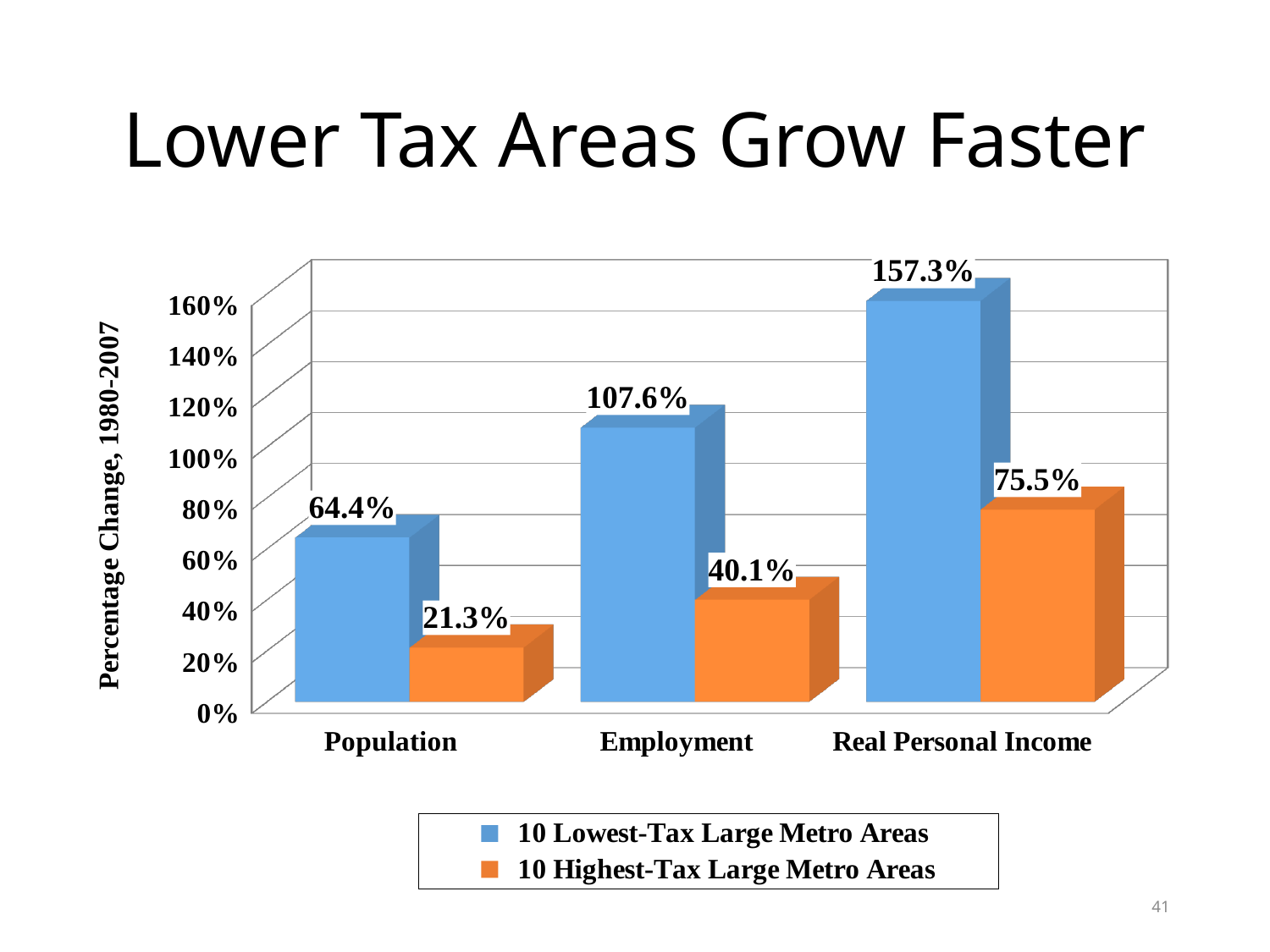
What is the percentage change in Population for the 10 Lowest-Tax Large Metro Areas? 64.4% What kind of chart is shown on the slide? bar chart What is the percentage change in Employment for the 10 Highest-Tax Large Metro Areas? 40.1% What is the label of the vertical axis? Percentage Change, 1980-2007 What is the difference between the Real Personal Income values for the 10 Lowest-Tax and 10 Highest-Tax Large Metro Areas? 81.8% How many categories are shown on the x axis? 3 Which is larger for Employment: the 10 Lowest-Tax Large Metro Areas or the 10 Highest-Tax Large Metro Areas? 10 Lowest-Tax Large Metro Areas What is the percentage change in Real Personal Income for the 10 Lowest-Tax Large Metro Areas? 157.3% Which category has the highest value for the 10 Lowest-Tax Large Metro Areas? Real Personal Income Which category has the lowest value for the 10 Highest-Tax Large Metro Areas? Population How many series does the legend list? 2 Is the Employment value for the 10 Lowest-Tax Large Metro Areas greater or less than 100%? greater